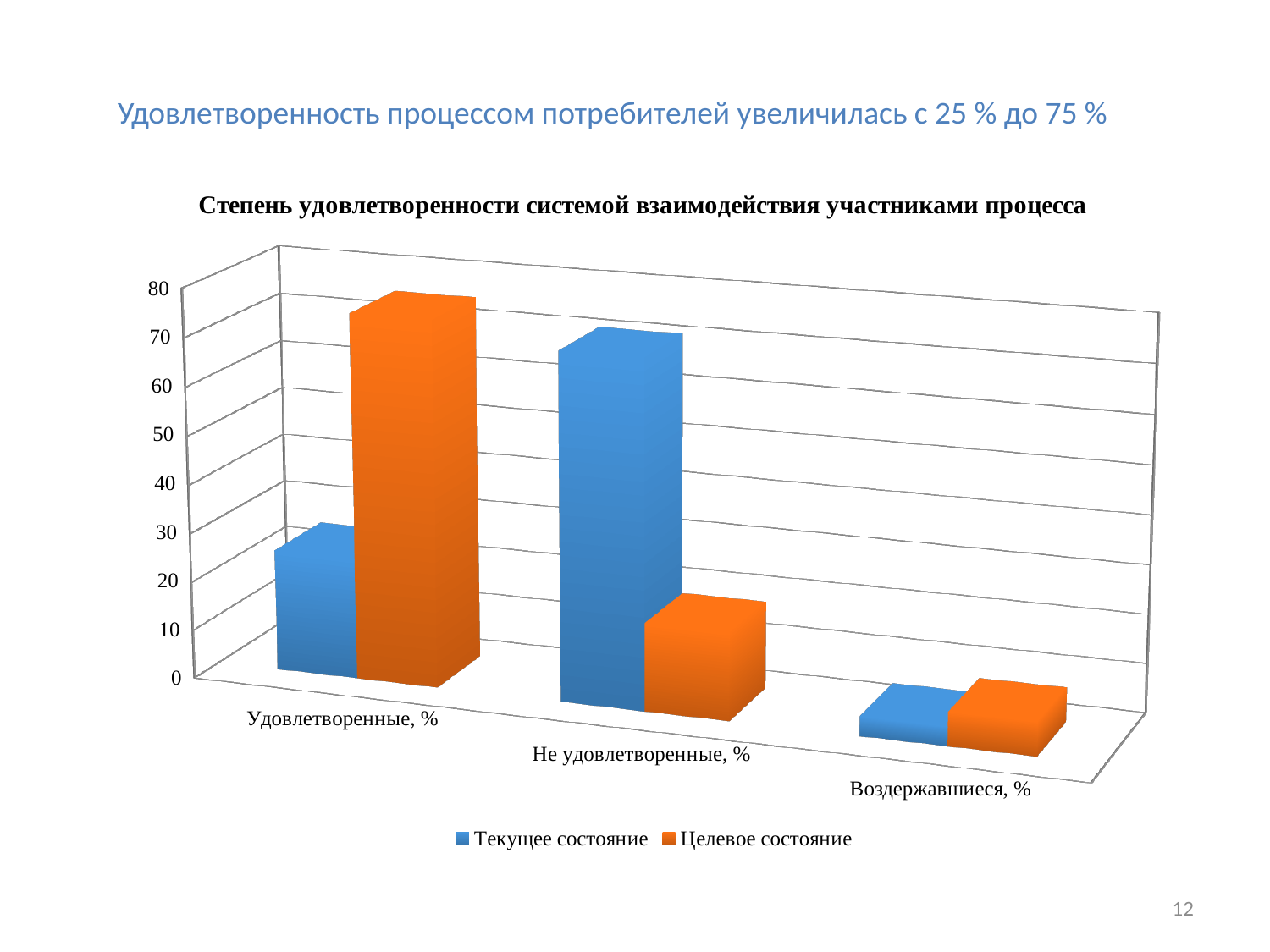
How many categories are shown on the x axis of the chart? 3 Is the Целевое состояние value for Не удовлетворенные, % greater or less than 30? less For Не удовлетворенные, %, which series has the larger value: Текущее состояние or Целевое состояние? Текущее состояние Is the Текущее состояние value for Удовлетворенные, % greater or less than 50? less How many series does the chart legend list? 2 Is the Целевое состояние value for Удовлетворенные, % greater or less than 60? greater Which colour represents the Целевое состояние series in the chart? orange What kind of chart is shown on the slide? bar chart Which category has the highest value for the Целевое состояние series? Удовлетворенные, % Which category has the lowest value for the Текущее состояние series? Воздержавшиеся, % Which category has the highest value for the Текущее состояние series? Не удовлетворенные, % For Удовлетворенные, %, which series has the larger value: Текущее состояние or Целевое состояние? Целевое состояние